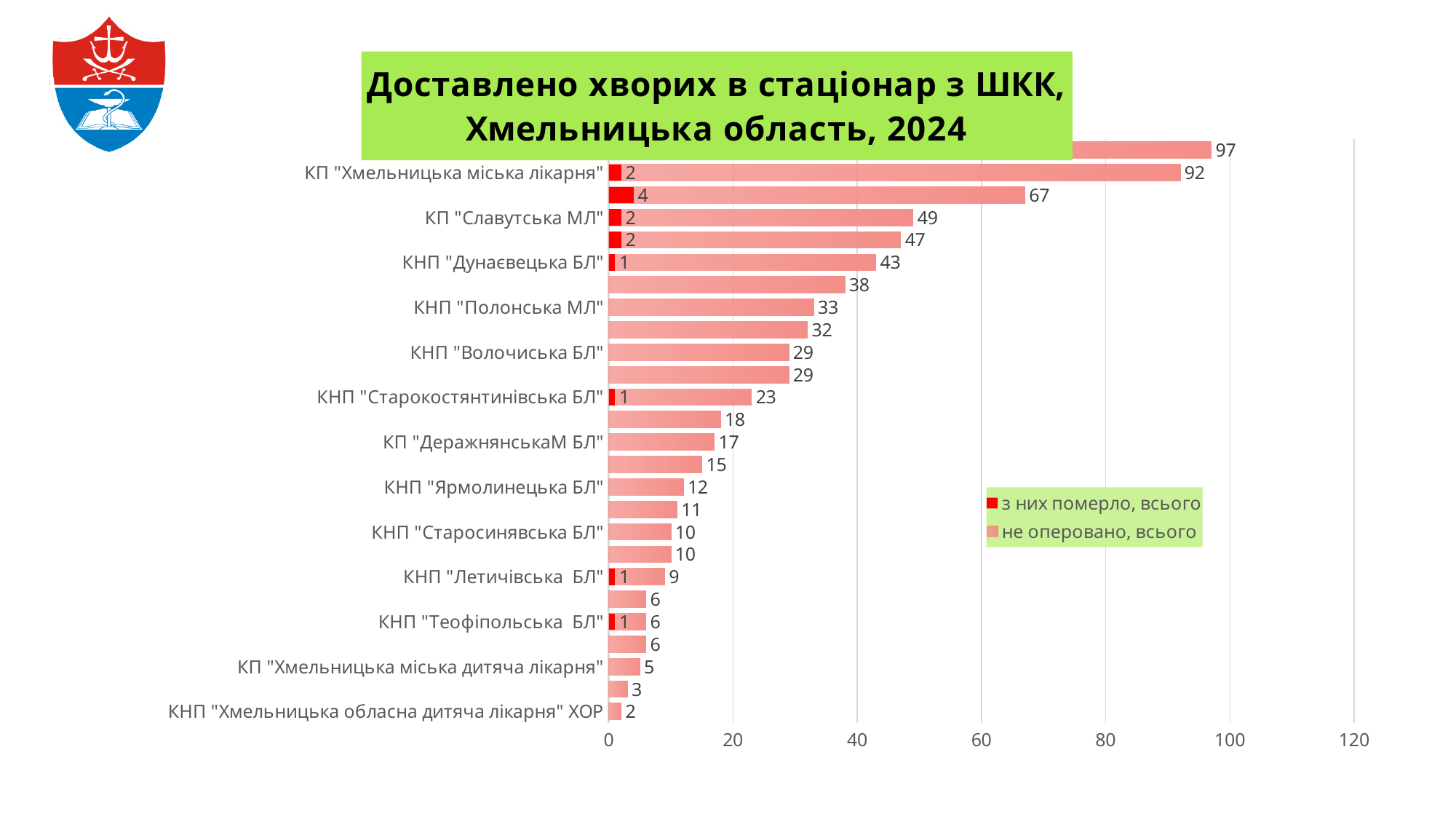
Which has a larger "не оперовано, всього" value: КНП "Полонська МЛ" or КНП "Волочиська БЛ"? КНП "Полонська МЛ" What kind of chart is shown on the slide? bar chart What is the title of the chart? Доставлено хворих в стаціонар з ШКК, Хмельницька область, 2024 What is the value of "не оперовано, всього" for КНП "Полонська МЛ"? 33 Which series is shown in red in the legend? з них померло, всього How many series does the legend list? 2 What is the difference in "не оперовано, всього" between КП "Хмельницька міська лікарня" and КП "Славутська МЛ"? 43 What is the value of "з них померло, всього" for КП "Славутська МЛ"? 2 What is the highest value shown for the "не оперовано, всього" series? 97 Is the "не оперовано, всього" value for КНП "Дунаєвецька БЛ" greater or less than 40? greater What is the value of "не оперовано, всього" for КП "Хмельницька міська лікарня"? 92 Which labelled category has the lowest value of "не оперовано, всього"? КНП "Хмельницька обласна дитяча лікарня" ХОР